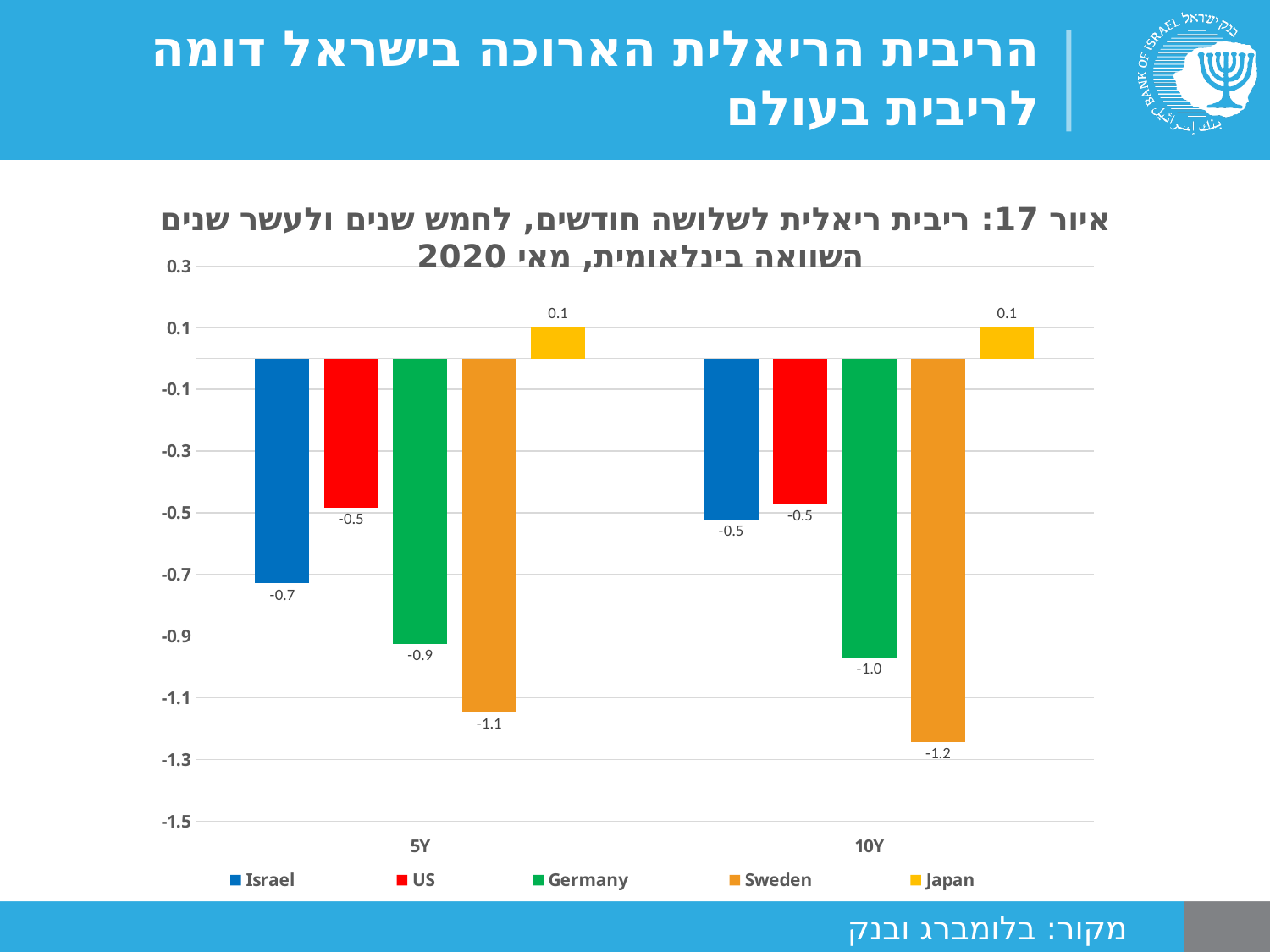
How many series does the legend list? 5 What is the value for Israel in the 5Y category? -0.7 Which series has the lowest value in the 5Y category? Sweden What is the value for Japan in the 5Y category? 0.1 Which is larger, the Germany value for 5Y or the Germany value for 10Y? 5Y What kind of chart is shown on the slide? bar chart Which series has the highest value in the 10Y category? Japan What is the value for Sweden in the 10Y category? -1.2 How many categories are shown on the x axis? 2 What is the difference between the Sweden and Israel values in the 5Y category? 0.4 What colour represents Sweden in the chart? orange What is the value for Germany in the 10Y category? -1.0